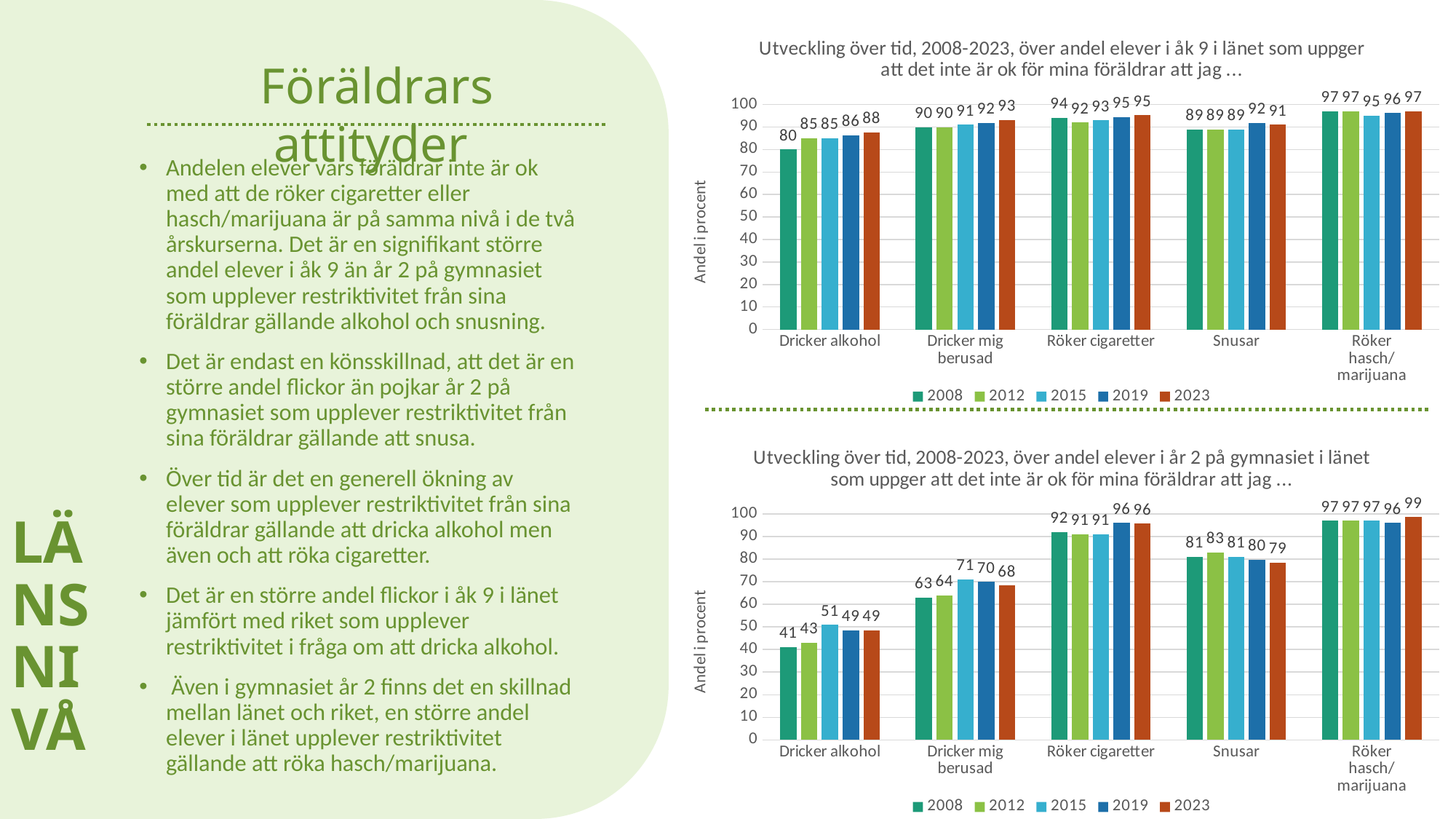
In the top chart (åk 9), what is the value for Dricker alkohol in 2008? 80 In the bottom chart (år 2 på gymnasiet), which is larger for Snusar: the 2012 value or the 2023 value? 2012 What type of chart is the top chart? Bar chart How many categories are shown on the x axis of the bottom chart? 5 In the bottom chart (år 2 på gymnasiet), what is the difference between the 2015 and 2008 values for Dricker alkohol? 10 In the bottom chart (år 2 på gymnasiet), what is the value for Röker hasch/marijuana in 2023? 99 In the top chart (åk 9), which category has the highest value for 2023? Röker hasch/marijuana How many series does the legend of the top chart list? 5 In the bottom chart (år 2 på gymnasiet), which category has the lowest value for 2008? Dricker alkohol In the bottom chart (år 2 på gymnasiet), what is the value for Dricker mig berusad in 2015? 71 In the top chart (åk 9), what is the difference between the 2023 and 2008 values for Dricker alkohol? 8 In the top chart (åk 9), what is the value for Snusar in 2019? 92